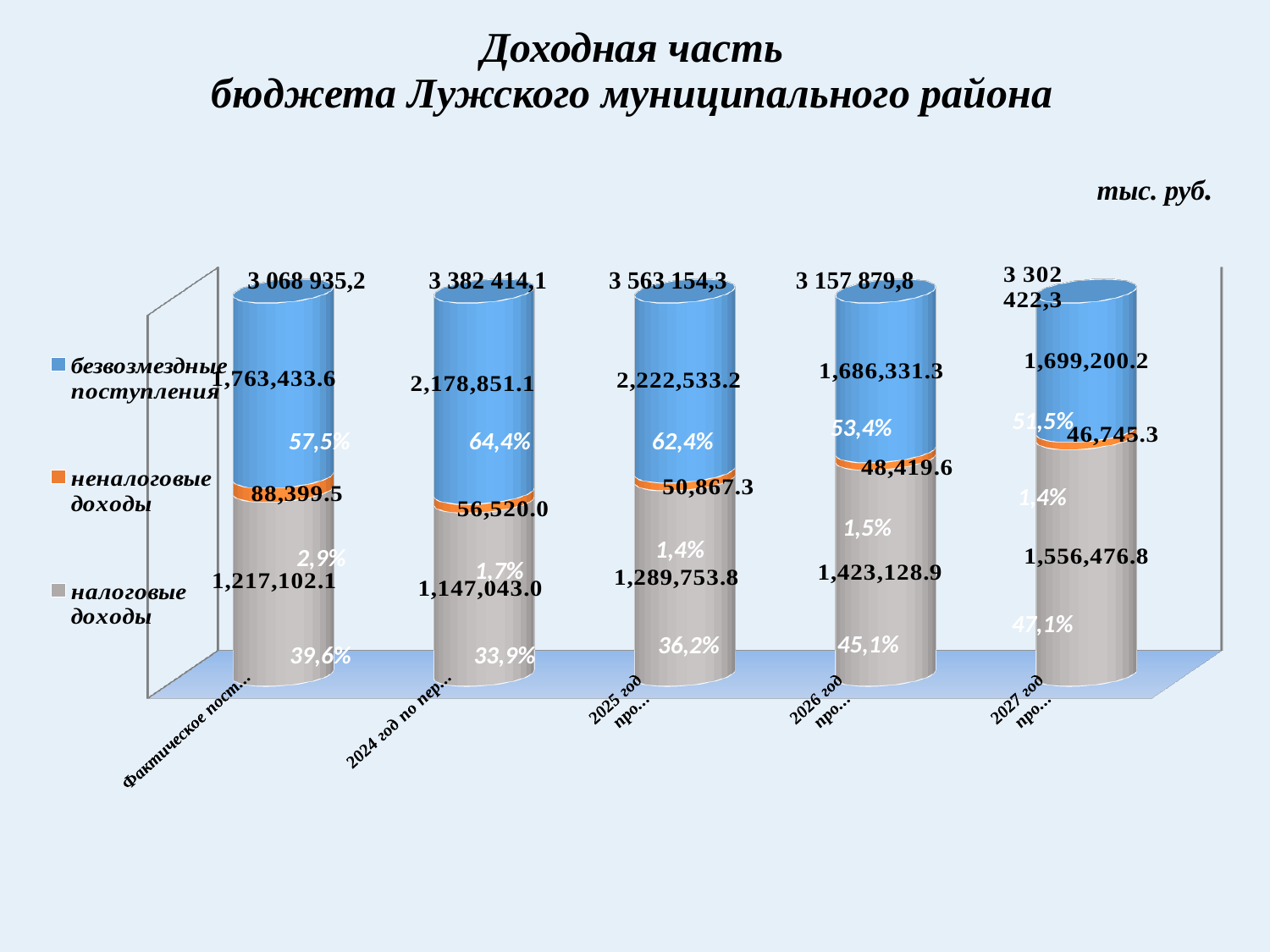
Which is larger: налоговые доходы in the 2024 bar or in the 2025 bar? 2025 How many series does the legend list? 3 What is the total printed above the 2025 bar? 3 563 154,3 What is the value of неналоговые доходы for the 2027 bar? 46,745.3 What kind of chart is shown on the slide? Stacked bar chart Which bar has the lowest value of неналоговые доходы? 2027 How many bars are shown in the chart? 5 What is the value of налоговые доходы for the 2025 bar? 1,289,753.8 What is the value of безвозмездные поступления for the 2024 bar? 2,178,851.1 What percentage share is shown for безвозмездные поступления in the 2026 bar? 53,4% Which bar has the highest value of безвозмездные поступления? 2025 What is the difference between налоговые доходы in the 2027 bar and in the 2026 bar? 133,347.9